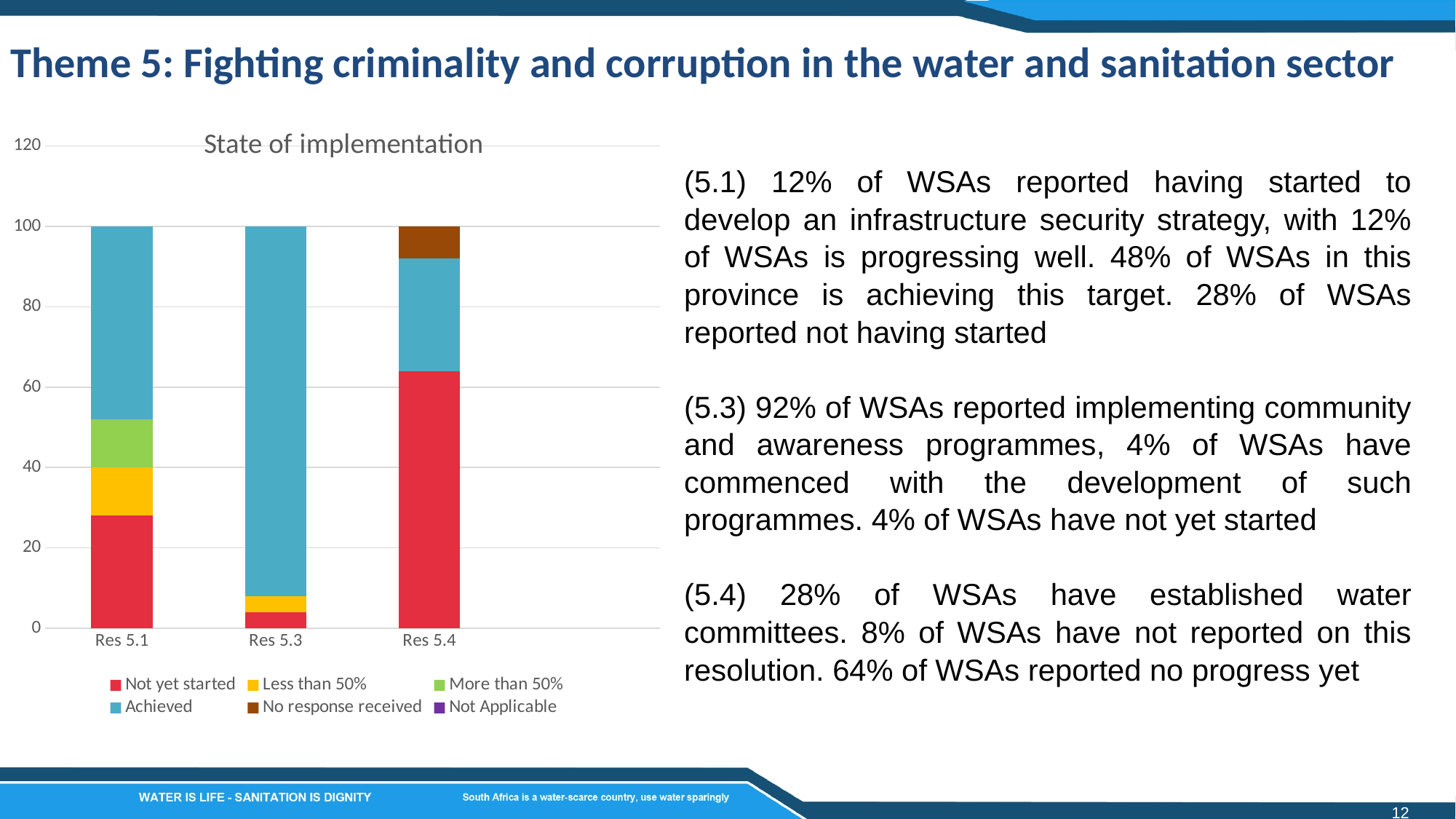
What kind of chart is shown on the slide? Stacked bar chart Which category has the largest 'Not yet started' segment? Res 5.4 What is the total height of the stacked bar for Res 5.1? 100 What is the title of the chart? State of implementation Which has the larger 'Achieved' segment, Res 5.3 or Res 5.4? Res 5.3 How many series does the chart legend list? 6 Which category has the smallest 'Not yet started' segment? Res 5.3 What is the total height of the stacked bar for Res 5.3? 100 Is the 'Not yet started' value for Res 5.4 greater or less than 60? greater Which category is the only one with a 'No response received' segment? Res 5.4 How many categories are shown on the x axis of the chart? 3 Is the 'Not yet started' value for Res 5.1 greater or less than 20? greater